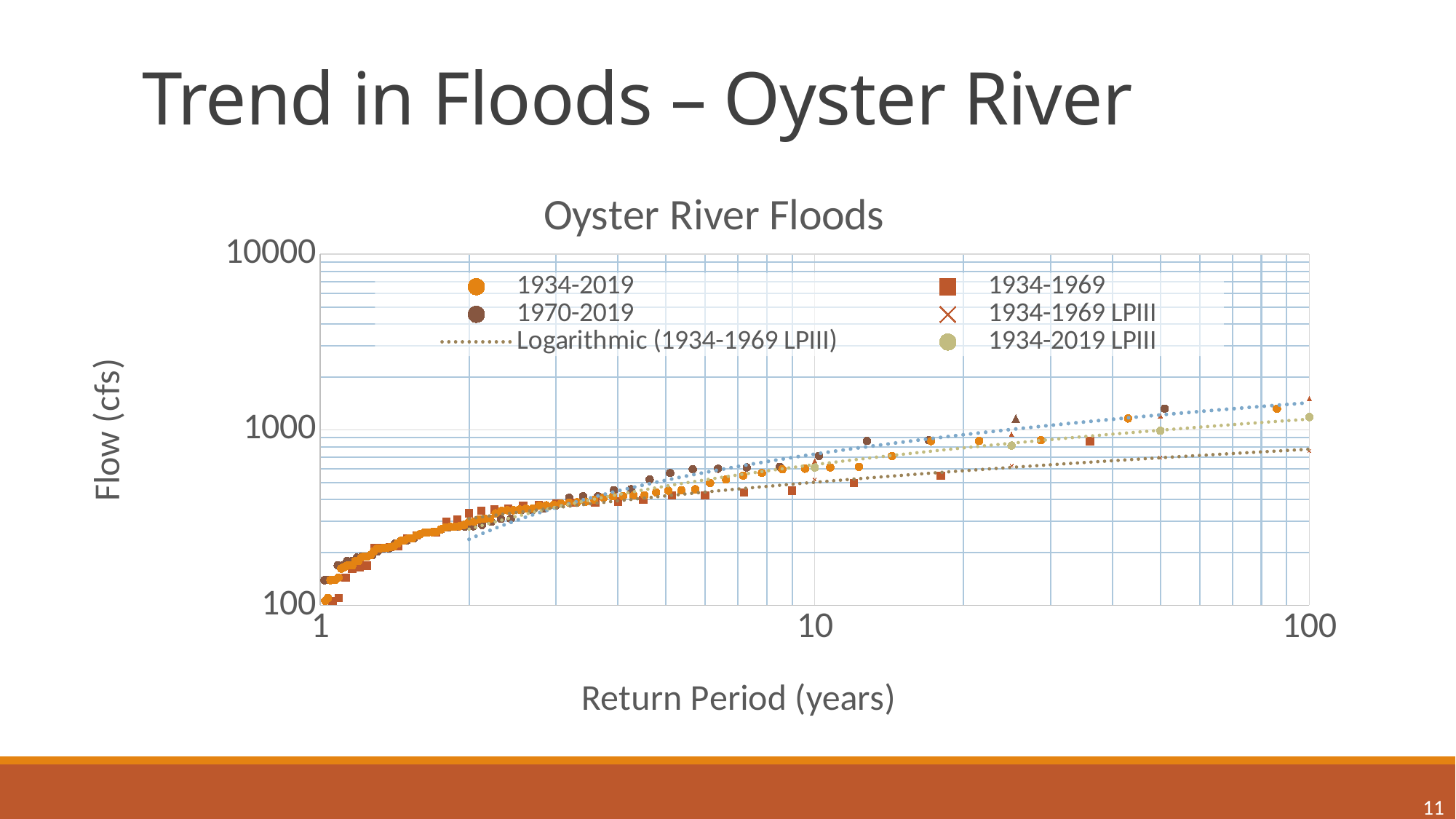
How many series does the chart legend list? 6 What is the title of the chart? Oyster River Floods Is the flow value for the 1934-1969 LPIII series at a return period of 100 years greater or less than 1000? less Is the flow value for the 1934-2019 series at a return period of 1 year greater or less than 1000? less What is the label of the chart's y axis? Flow (cfs) At a return period of 100 years, which series has the higher flow: 1934-2019 or 1934-1969 LPIII? 1934-2019 What kind of chart is shown on the slide? Scatter chart Is the flow value for the 1934-2019 series at a return period of 10 years greater or less than 1000? less Do the flow values rise or fall as the return period increases along the x axis? Rise What is the highest value shown on the y axis of the chart? 10000